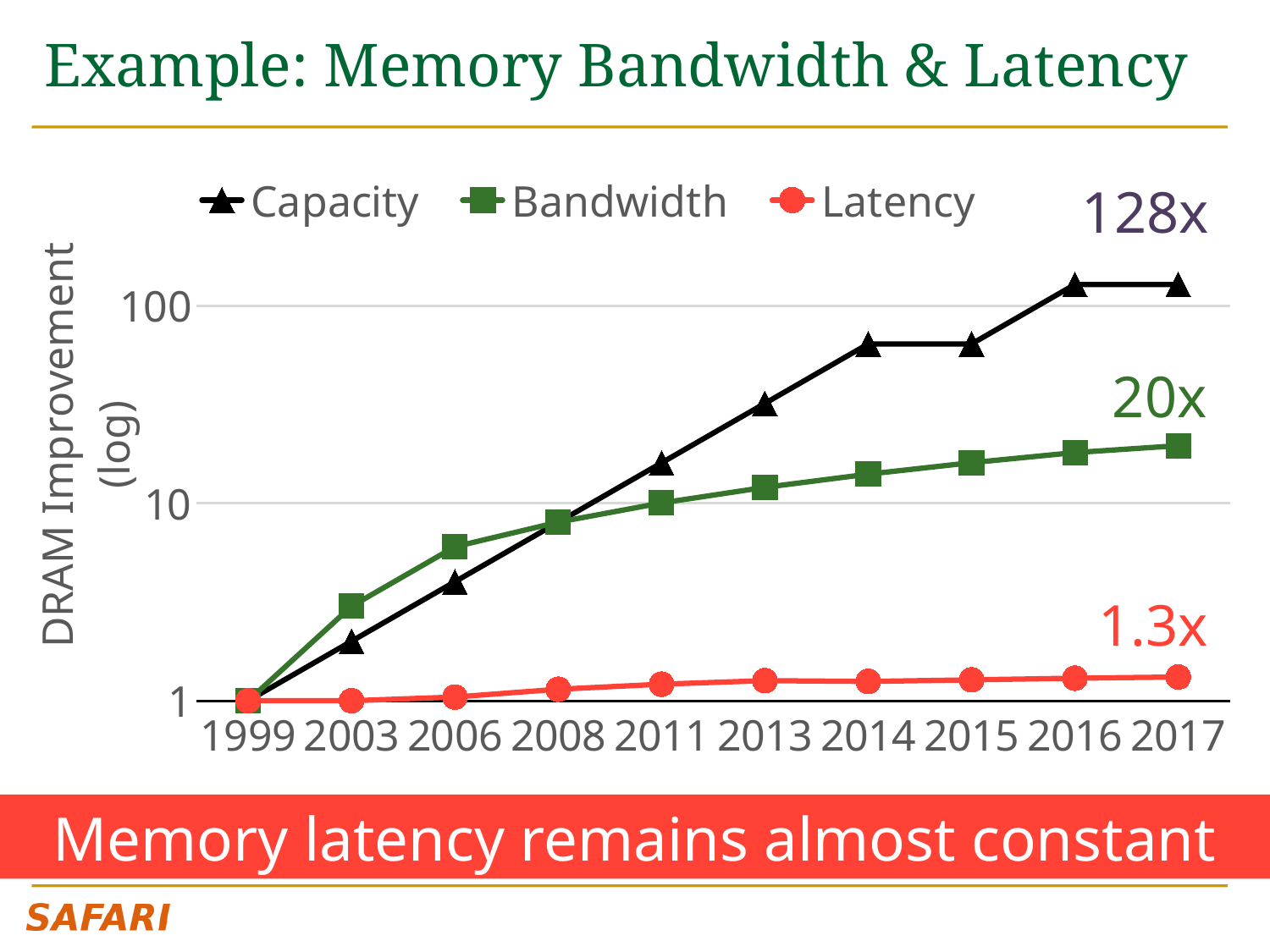
What is the Latency improvement in 2017? 1.3x What kind of chart is shown on the slide? line chart In 2003, which is larger: Bandwidth or Capacity? Bandwidth How many series does the legend list? 3 Which series has the lowest value in 2017? Latency Does the Capacity series rise or fall from 1999 to 2017? rise What is the label of the y axis? DRAM Improvement (log) What is the Capacity improvement in 2017? 128x Which series has the highest value in 2017? Capacity How many years are shown on the x axis? 10 What is the Bandwidth improvement in 2017? 20x Is the Capacity value for 2016 greater or less than 100? greater